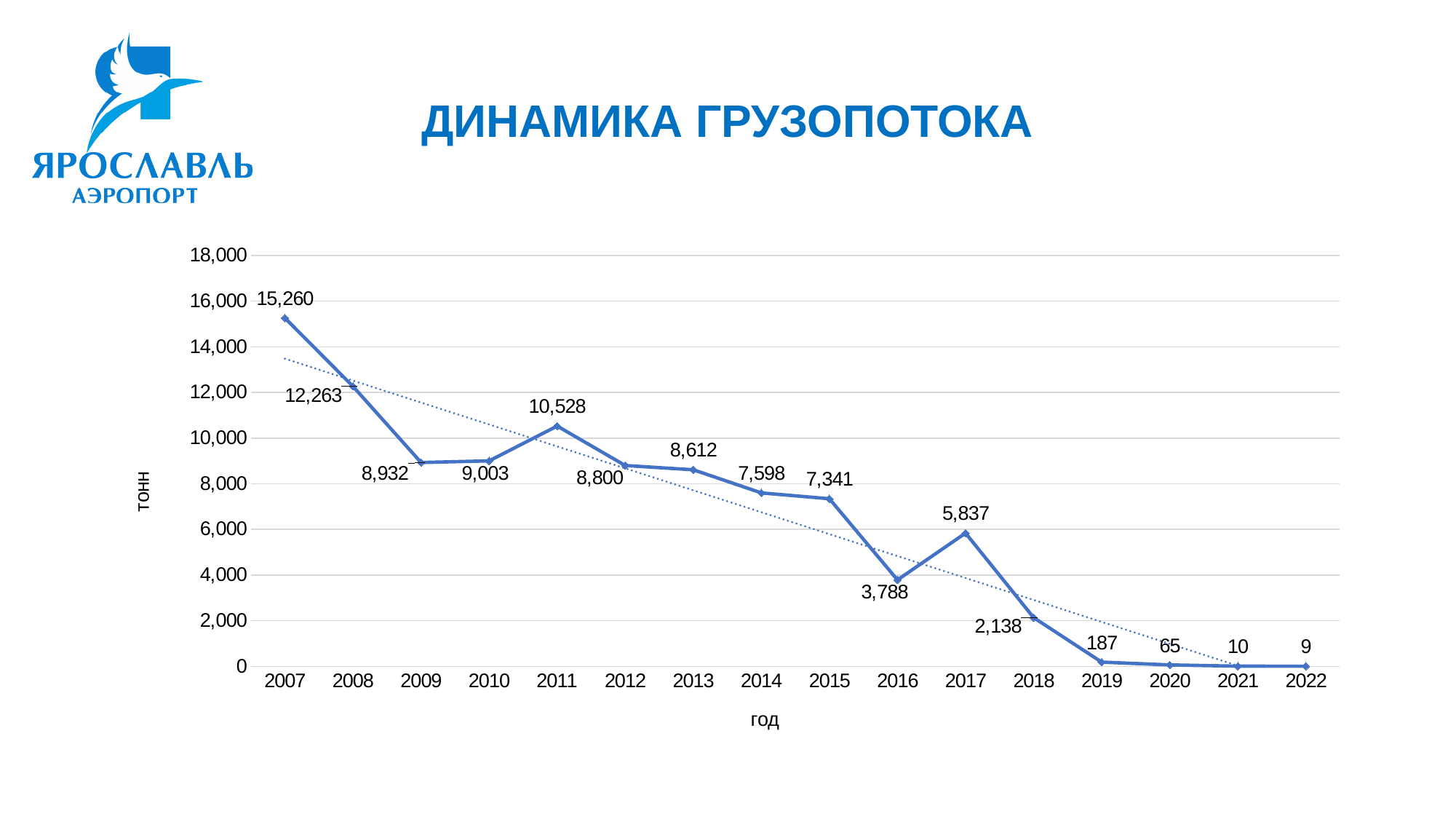
Do the values generally rise or fall from 2007 to 2022? fall Which is larger, the value for 2010 or the value for 2011? 2011 What is the value plotted for 2022? 9 What is the cargo volume value for 2007? 15,260 What is the value plotted for 2017? 5,837 Is the value for 2013 greater or less than 8,000? greater What kind of chart is shown on the slide? line chart What is the difference between the values for 2016 and 2017? 2,049 Which year has the lowest value on the chart? 2022 Which year has the highest value on the chart? 2007 What is the difference between the values for 2007 and 2008? 2,997 How many years are shown on the x axis? 16